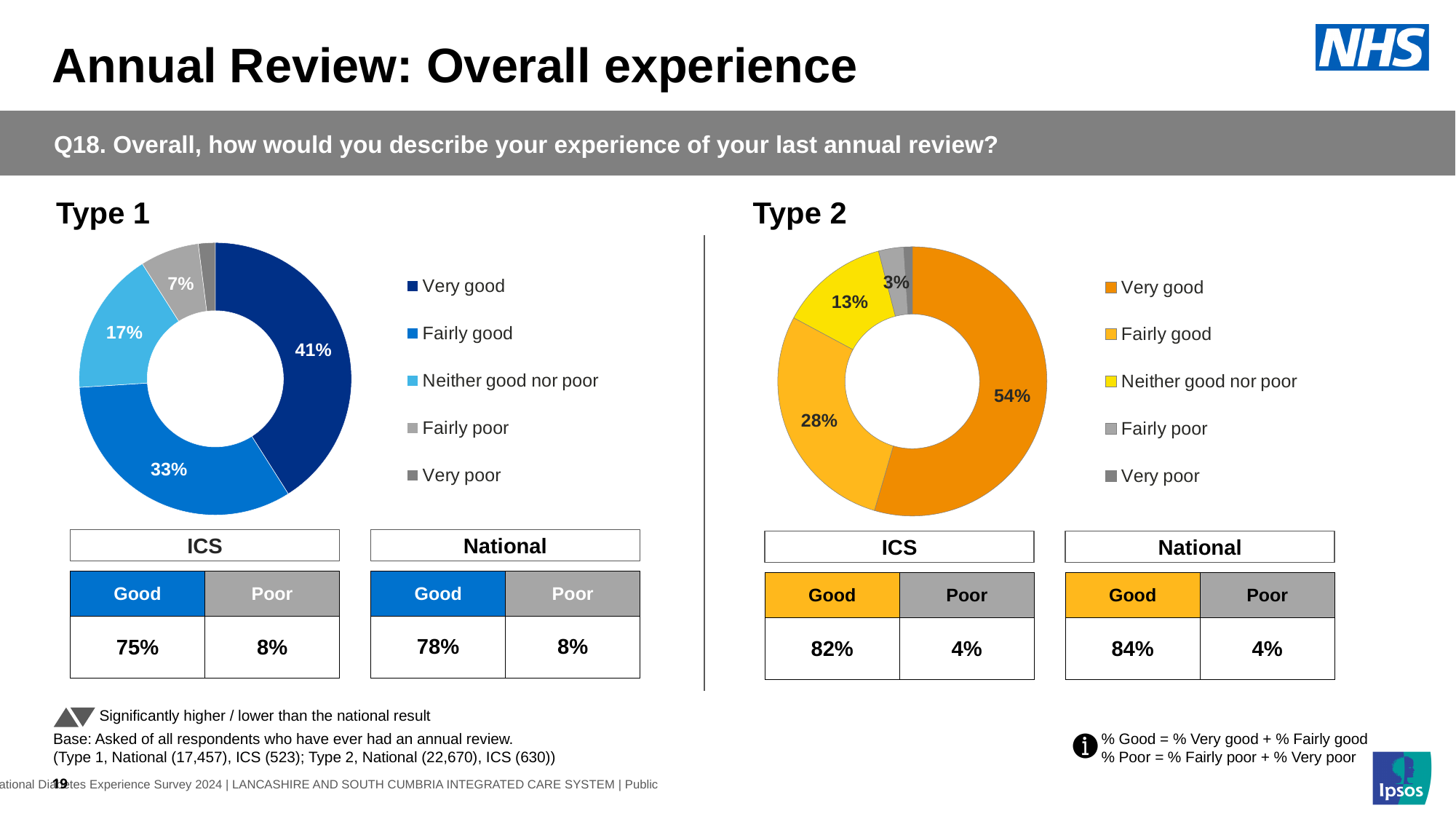
How many response categories does the legend of the Type 2 chart list? 5 In the Type 1 chart, what is the difference between the Very good and Fairly good shares? 8 percentage points In the Type 2 chart, what percentage said Neither good nor poor? 13% In the Type 2 chart, what percentage said Fairly good? 28% In the Type 2 chart, which response category has the largest share? Very good In the Type 1 chart, what percentage of respondents said their experience was Very good? 41% In the Type 1 chart, what percentage of respondents said Fairly good? 33% What kind of chart is used to show the Type 1 results? Donut (pie) chart Which is larger: the Very good share in the Type 1 chart or the Very good share in the Type 2 chart? Type 2 In the Type 2 chart, what percentage of respondents said Very good? 54% In the Type 1 chart, which response category has the largest share? Very good In the Type 1 chart, what percentage said Neither good nor poor? 17%